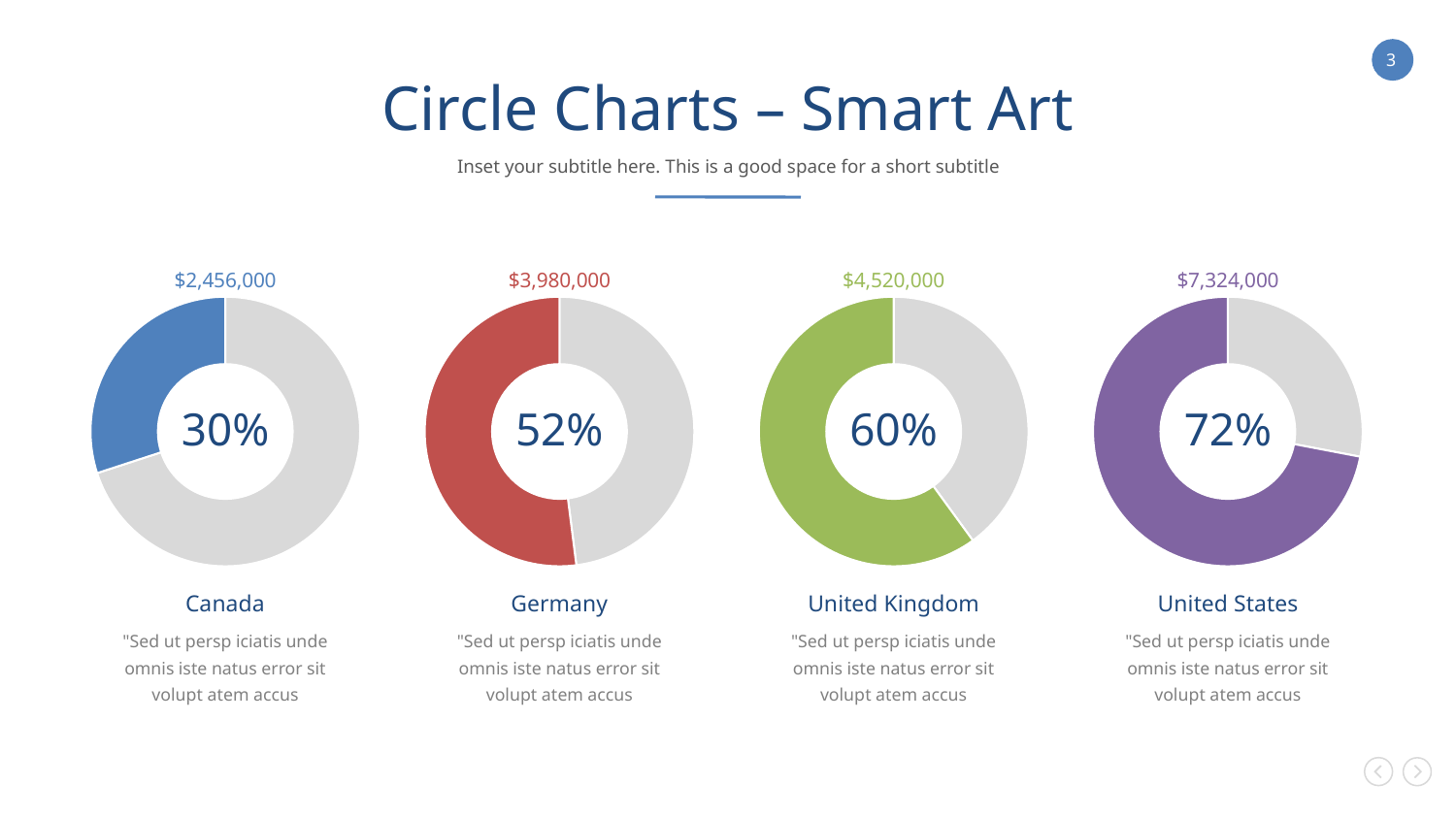
What dollar value is printed above the United Kingdom donut chart? $4,520,000 What percentage is shown in the centre of the Canada donut chart? 30% What is the difference in percentage points between the United States chart and the Canada chart? 42 How many donut charts are on the slide? 4 What kind of chart is used for each country on the slide? Donut chart What is the difference in percentage points between the United Kingdom chart and the Germany chart? 8 Which country's donut chart shows the lowest dollar value? Canada Which country's donut chart shows the highest percentage? United States What percentage is shown in the centre of the Germany donut chart? 52% What dollar value is printed above the United States donut chart? $7,324,000 Which shows a larger percentage, the Germany chart or the United Kingdom chart? United Kingdom What colour is the filled segment of the Germany donut chart? Red